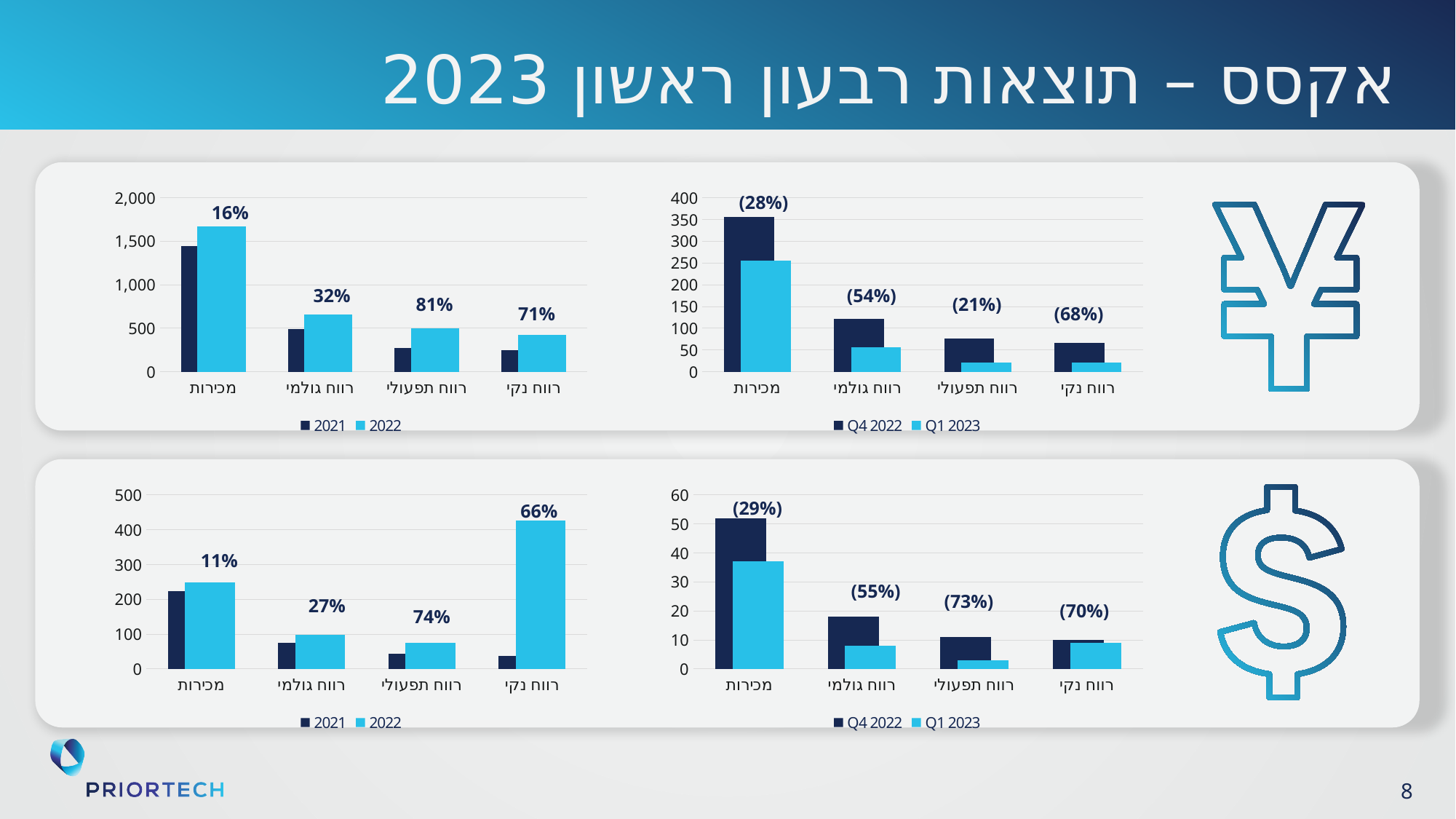
In the bottom-left chart, what percentage label is shown above the רווח נקי bars? 66% In the top-right chart, how many series does the legend list? 2 In the bottom-left chart, is the 2022 value for מכירות greater or less than 200? greater In the top-left chart, what percentage label is shown above the מכירות bars? 16% In the top-left chart, which category has the highest percentage label? רווח תפעולי In the bottom-right chart, what percentage label is shown above the רווח תפעולי bars? (73%) In the top-left chart, how many categories are shown on the x axis? 4 What kind of chart is the bottom-left chart? Bar chart In the top-right chart, what percentage label is shown above the רווח גולמי bars? (54%) In the top-right chart, is the Q4 2022 value for מכירות greater or less than 300? greater In the bottom-right chart, is the Q4 2022 value for מכירות greater or less than 40? greater In the top-left chart, is the 2022 bar for מכירות taller than the 2021 bar? Yes, 2022